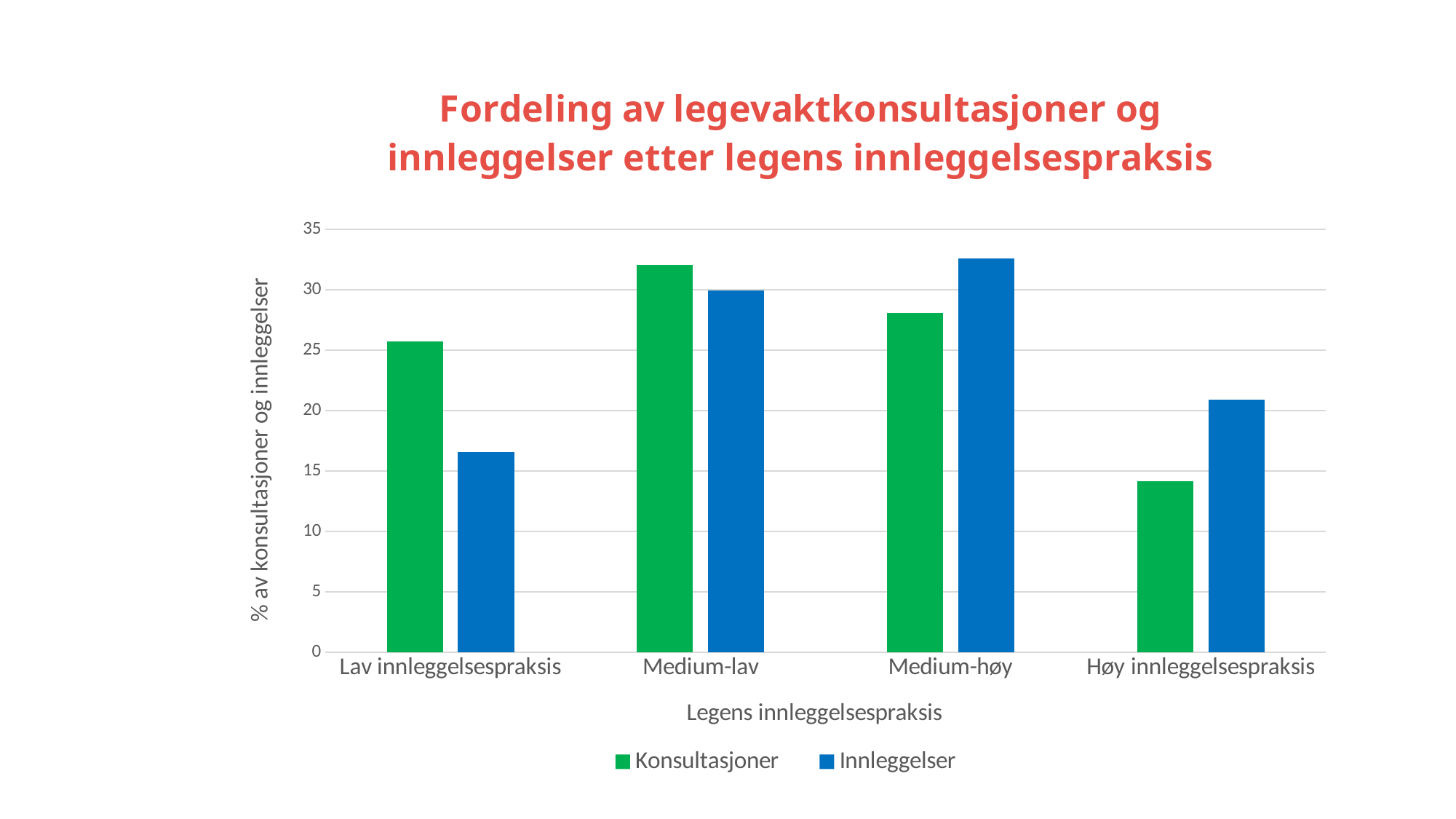
For Høy innleggelsespraksis, which series is larger, Konsultasjoner or Innleggelser? Innleggelser For Lav innleggelsespraksis, which series is larger, Konsultasjoner or Innleggelser? Konsultasjoner How many series does the legend list? 2 Is the value for Konsultasjoner at Medium-lav greater or less than 30? greater Which colour represents the Innleggelser series in the legend? Blue Which category has the lowest value for Konsultasjoner? Høy innleggelsespraksis Which category has the highest value for Innleggelser? Medium-høy Which category has the lowest value for Innleggelser? Lav innleggelsespraksis How many categories are shown on the x axis? 4 Which category has the highest value for Konsultasjoner? Medium-lav What kind of chart is shown on the slide? Bar chart Is the value for Innleggelser at Lav innleggelsespraksis greater or less than 20? less